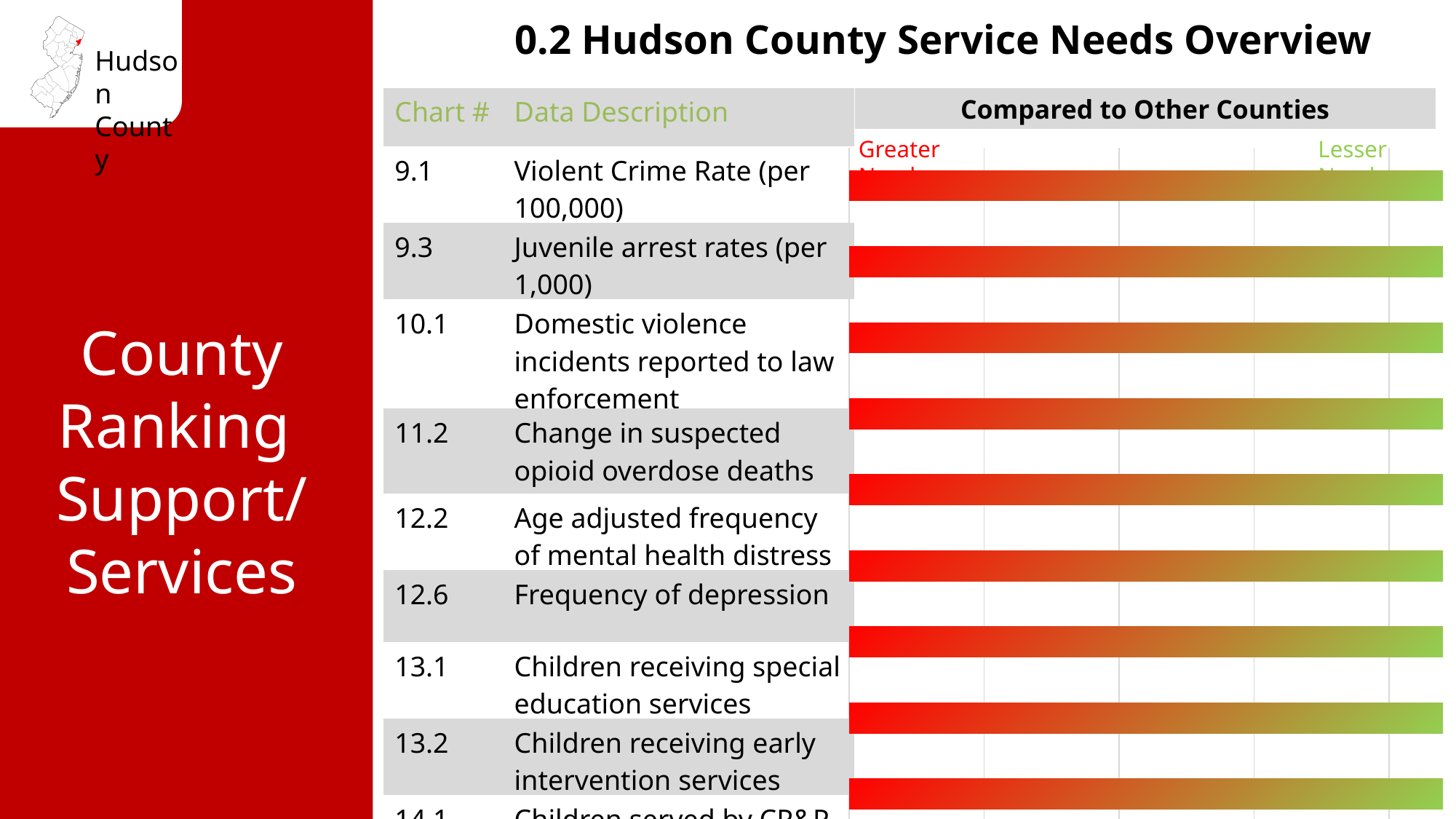
What kind of chart is shown under 'Compared to Other Counties'? bar chart Which chart number corresponds to 'Frequency of depression'? 12.6 How many bars are shown in the 'Compared to Other Counties' chart? 9 What colour is the left end of each bar in the 'Compared to Other Counties' chart? red What data description is listed for chart number 13.2? Children receiving early intervention services Which chart number corresponds to 'Violent Crime Rate (per 100,000)'? 9.1 What is the title of the chart on the right side of the slide? Compared to Other Counties What data description is listed for chart number 11.2? Change in suspected opioid overdose deaths